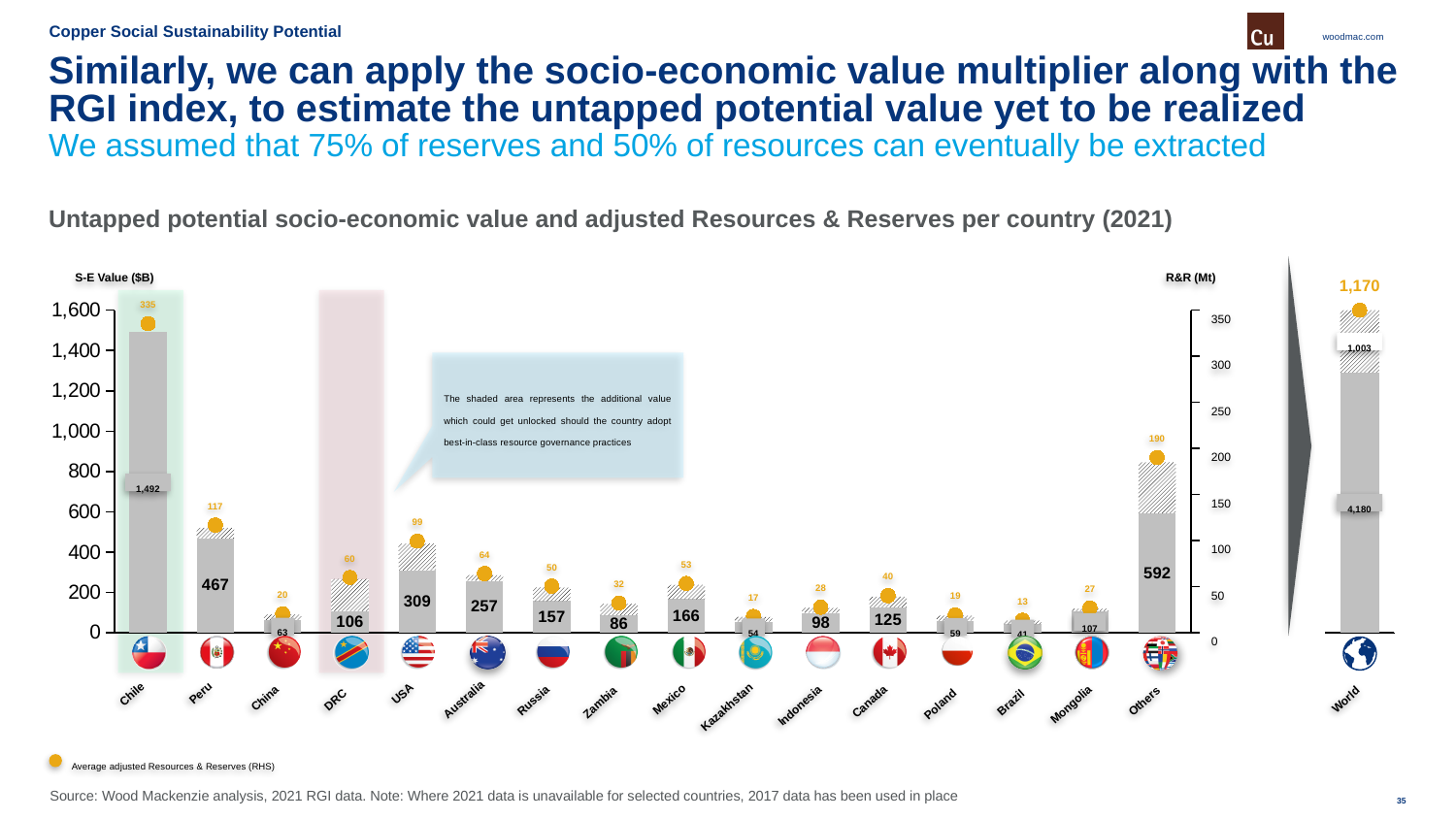
What is the average adjusted Resources & Reserves (Mt) value shown for Chile? 335 What type of chart is used to show the untapped socio-economic value per country? Bar chart Which has a larger S-E Value bar label, Australia or Russia? Australia What is the S-E Value ($B) label shown on the bar for Others? 592 What does the orange dot in the legend represent? Average adjusted Resources & Reserves (RHS) What is the S-E Value ($B) label shown on the bar for Mongolia? 107 What is the untapped socio-economic value (S-E Value, $B) shown for Chile? 1,492 How many country categories (including Others, excluding World) are shown on the main chart? 16 Which country has the highest untapped socio-economic value bar? Chile What is the R&R (Mt) value shown for World? 1,170 Which country has the lowest S-E Value ($B) bar label? Brazil What is the difference between the S-E Value bar labels for Peru and USA? 158